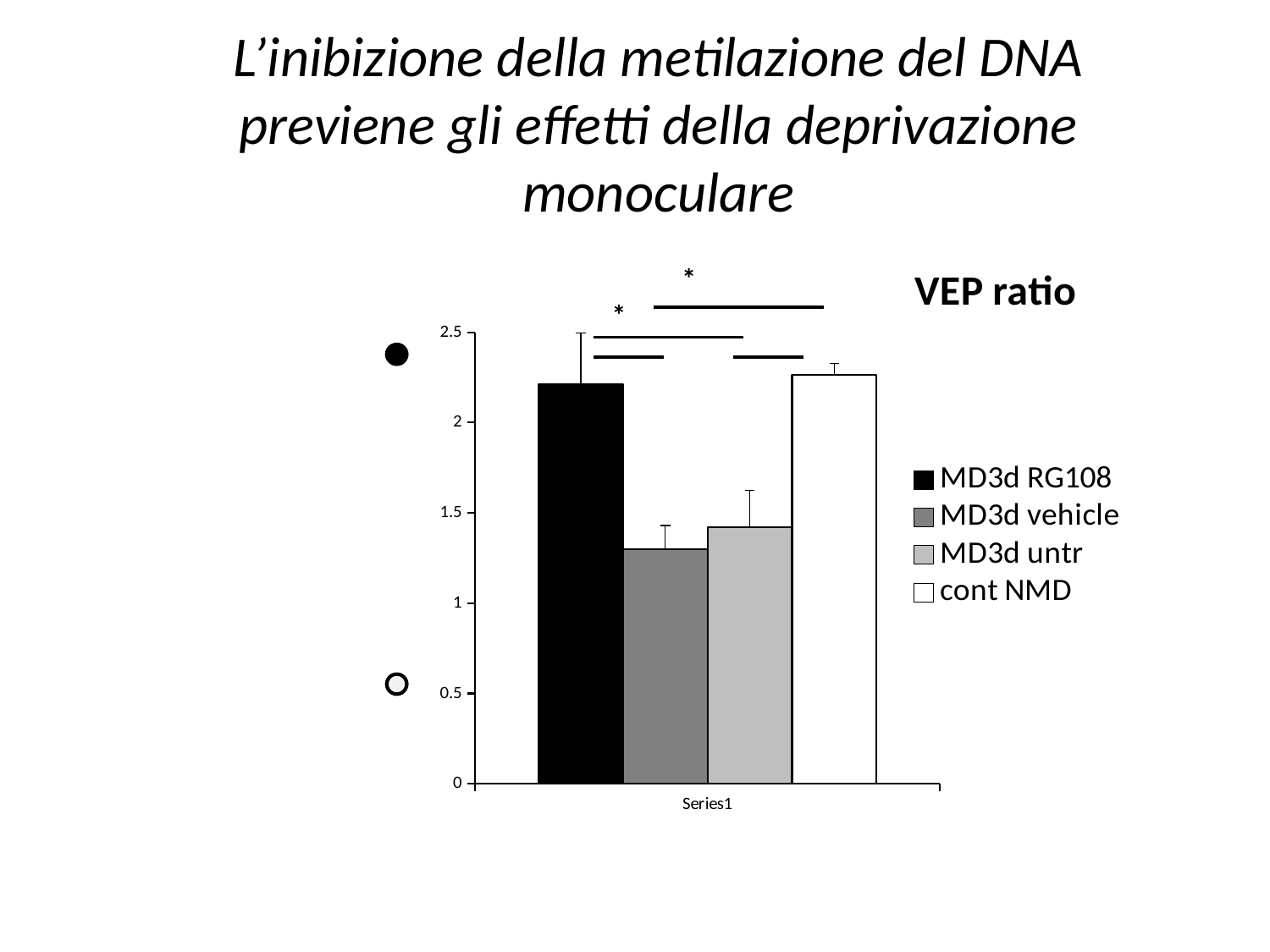
Is the value for MD3d RG108 greater or less than 2? greater Is the value for MD3d vehicle greater or less than 1.5? less Which is larger, the value for MD3d RG108 or the value for MD3d vehicle? MD3d RG108 What is the title shown next to the chart? VEP ratio Is the value for cont NMD greater or less than 2? greater How many series does the legend list? 4 Which is larger, the value for cont NMD or the value for MD3d untr? cont NMD Which series has the lowest value? MD3d vehicle What kind of chart is shown on the slide? bar chart Which legend entry is drawn in black? MD3d RG108